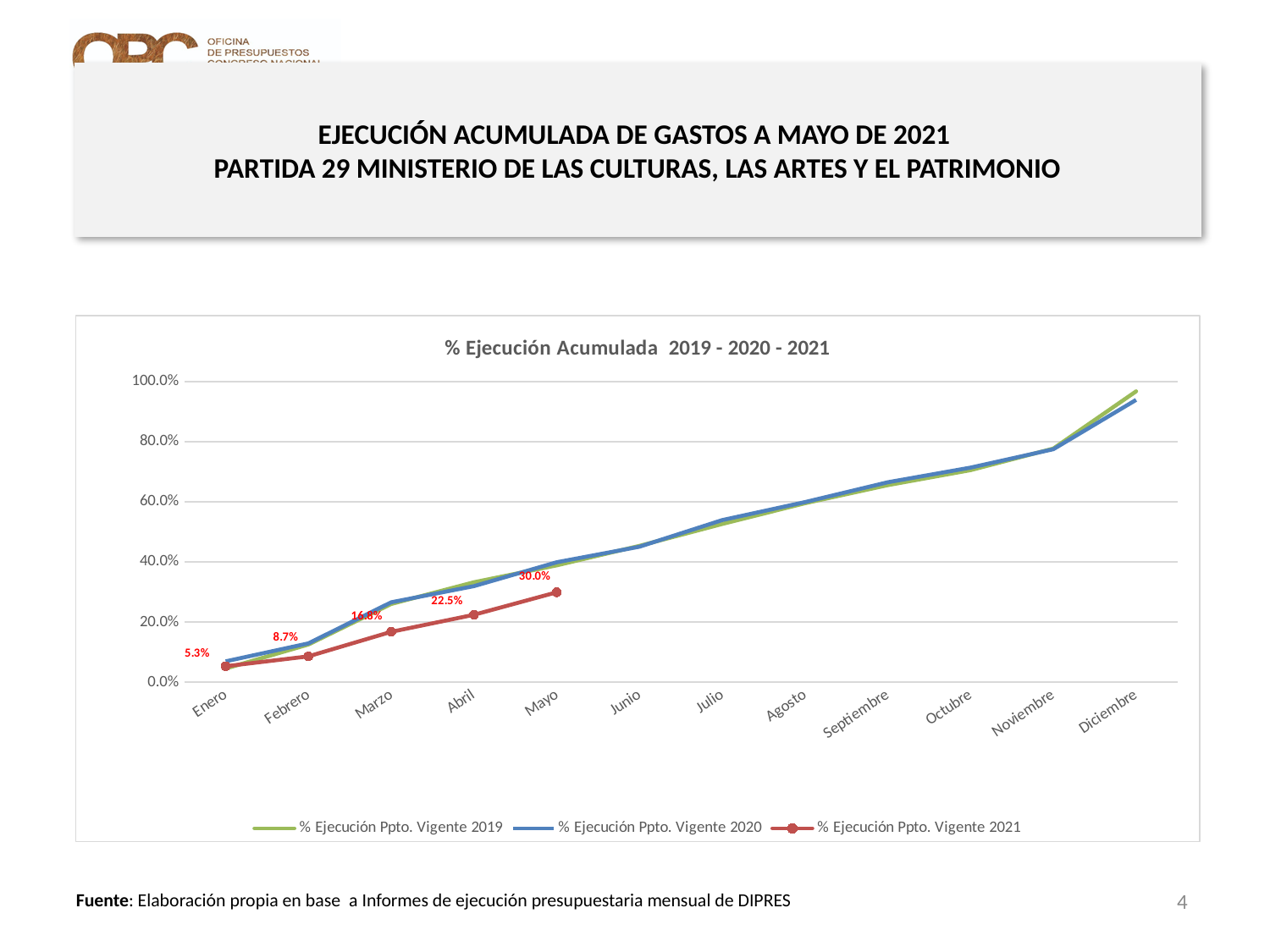
How many months are shown on the x axis of the chart? 12 What kind of chart is shown on the slide? Line chart How many series does the chart legend list? 3 What is the value for Mayo in the % Ejecución Ppto. Vigente 2021 series? 30.0% Is the value for Diciembre in the % Ejecución Ppto. Vigente 2020 series greater or less than 80.0%? greater What is the value for Febrero in the % Ejecución Ppto. Vigente 2021 series? 8.7% What is the value for Abril in the % Ejecución Ppto. Vigente 2021 series? 22.5% What is the title of the chart? % Ejecución Acumulada 2019 - 2020 - 2021 In Mayo, which series is higher: % Ejecución Ppto. Vigente 2020 or % Ejecución Ppto. Vigente 2021? % Ejecución Ppto. Vigente 2020 Which month has the highest value in the % Ejecución Ppto. Vigente 2021 series? Mayo What is the value for Enero in the % Ejecución Ppto. Vigente 2021 series? 5.3% By how many percentage points did the % Ejecución Ppto. Vigente 2021 series increase from Abril to Mayo? 7.5